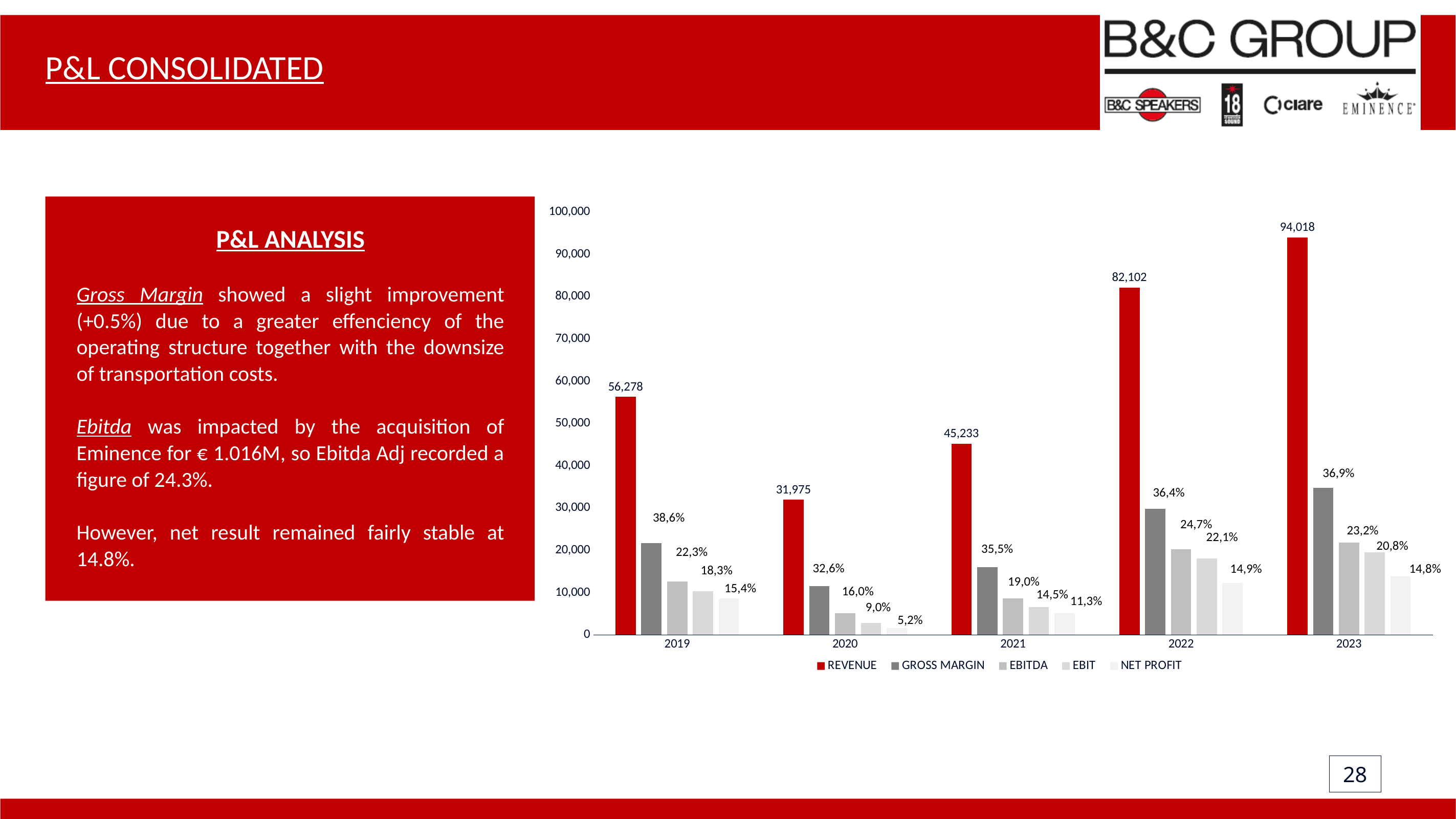
Which year has the lowest REVENUE? 2020 How many series does the legend list? 5 What is the REVENUE value for 2020? 31,975 What type of chart is shown on the slide? bar chart What is the difference in REVENUE between 2023 and 2022? 11,916 Which year has the highest REVENUE? 2023 Is the REVENUE for 2021 greater or less than 50,000? less How many years are shown on the x axis? 5 What is the GROSS MARGIN label for 2019? 38,6% What is the EBITDA label for 2022? 24,7% What is the NET PROFIT label for 2020? 5,2% What is the REVENUE value for 2023? 94,018